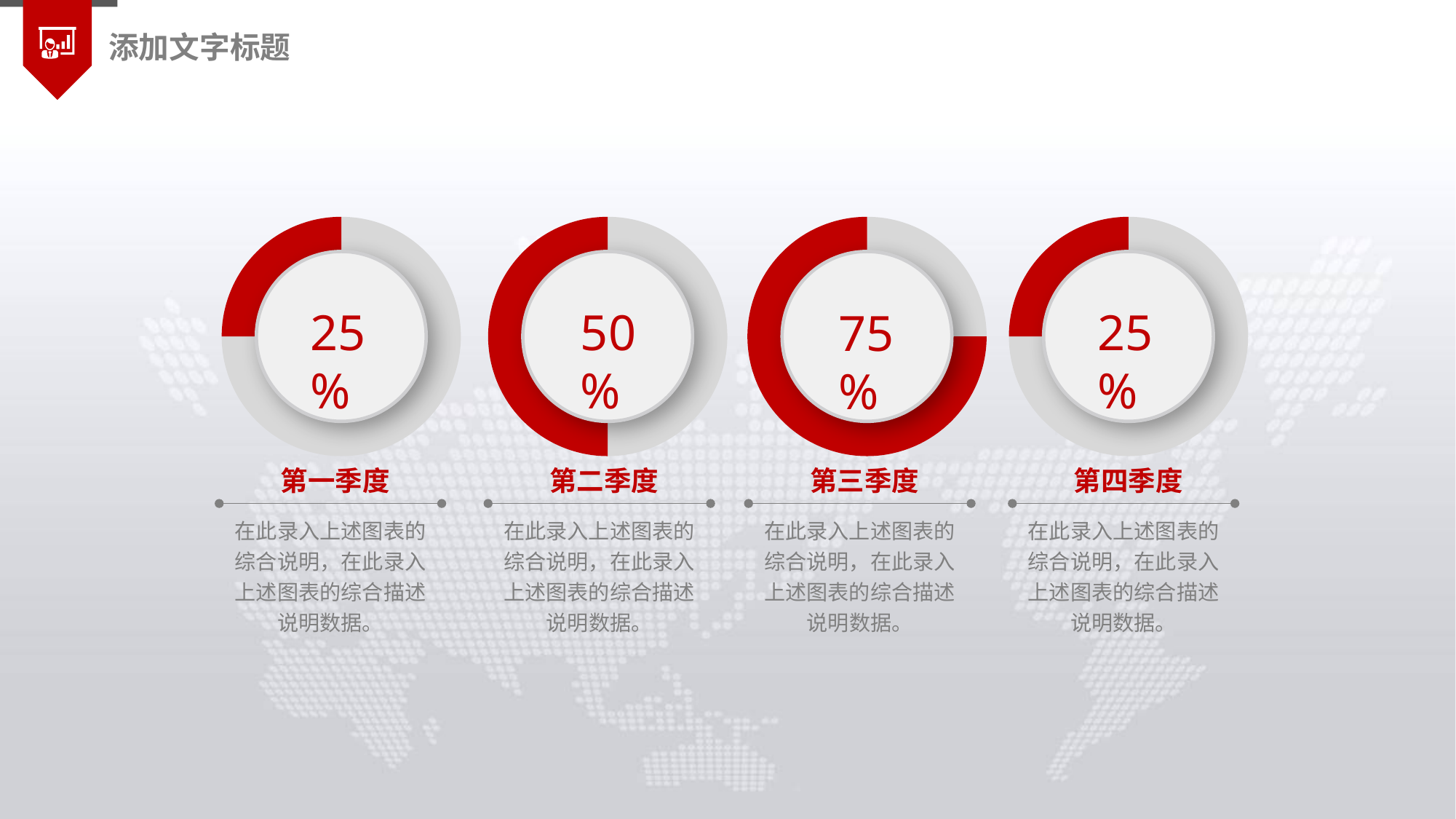
What value is shown in the 第四季度 ring chart? 25% What value is shown in the 第二季度 ring chart? 50% Which is larger, the 第二季度 value or the 第一季度 value? 第二季度 What value is shown in the 第三季度 ring chart? 75% What colour is used for the filled portion of each ring chart? Red Which is larger, the 第三季度 value or the 第四季度 value? 第三季度 What kind of chart is used to display each quarter's percentage? Donut (ring) chart How many ring charts are shown on the slide? 4 What is the difference between the 第三季度 value and the 第一季度 value? 50% What is the difference between the 第二季度 value and the 第四季度 value? 25% What value is shown in the 第一季度 ring chart? 25% Which quarter has the highest percentage among the four ring charts? 第三季度